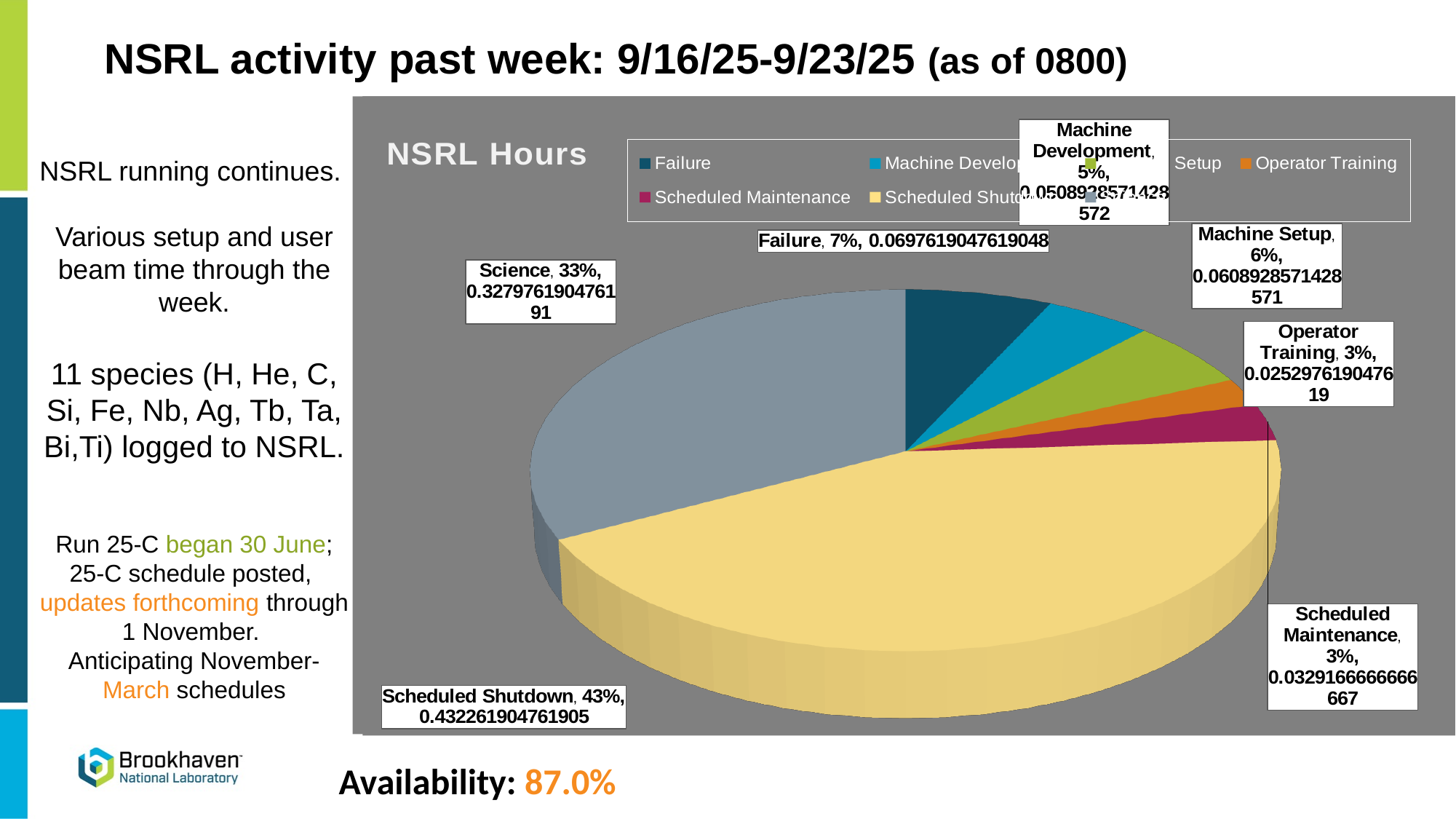
How many slices does the pie chart have? 7 Which is larger, the Failure slice or the Machine Setup slice? Failure What percentage share does the Machine Development slice have? 5% Which category has the largest slice of the pie? Scheduled Shutdown What colour is the Scheduled Shutdown slice? yellow What is the title of the chart? NSRL Hours What percentage share does the Failure slice have? 7% What percentage share does the Scheduled Shutdown slice have? 43% What type of chart is shown on the slide? pie chart What is the difference in percentage points between the Scheduled Shutdown and Science slices? 10